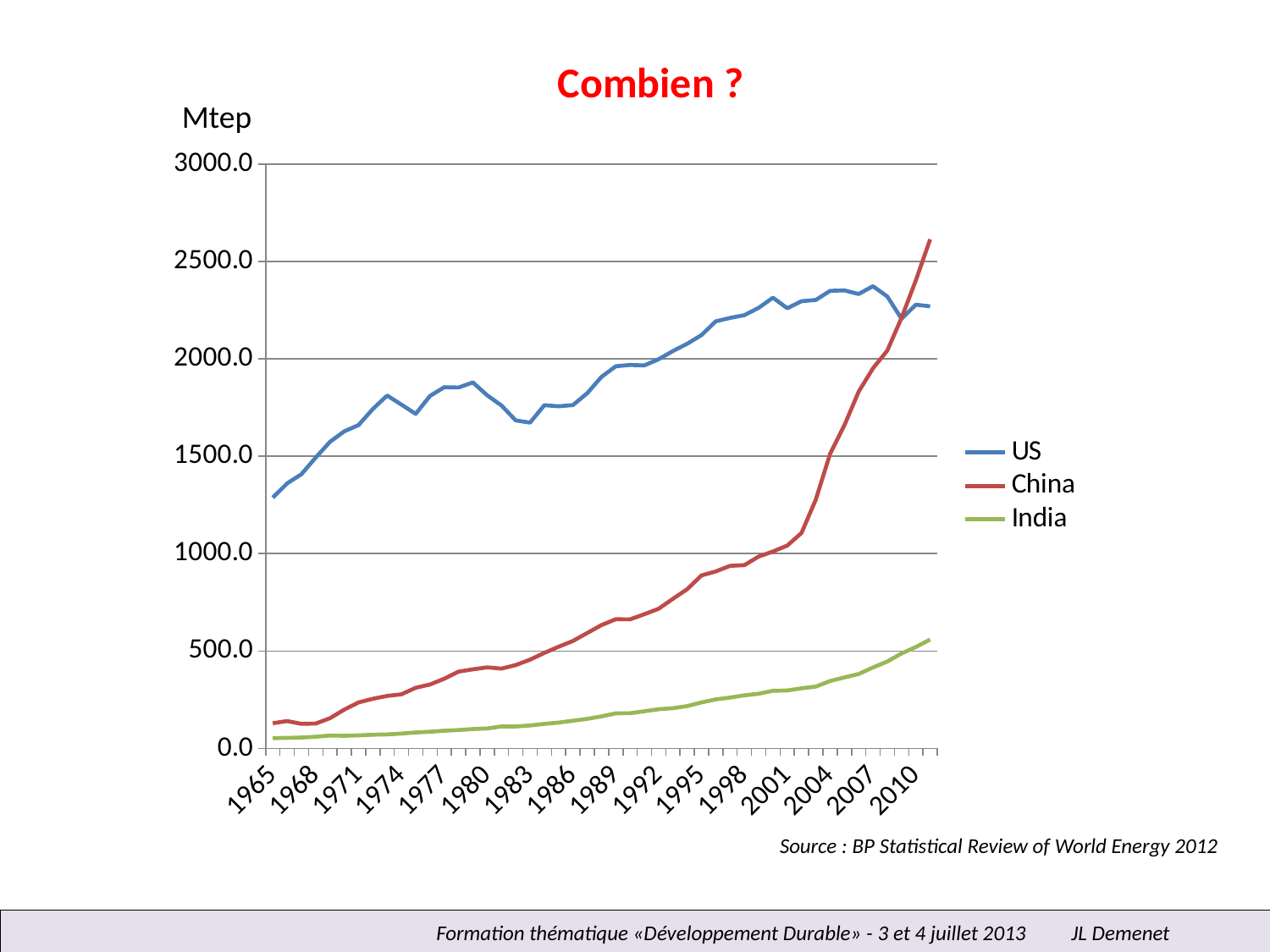
Is the value for US in 2010 greater or less than 2500.0? less How many series does the legend list? 3 Which series has the highest value at the right end of the chart (after 2010)? China Which series has the lowest value in 2010? India Which series are listed in the legend? US, China, India Which series has the highest value in 1965? US What kind of chart is shown on the slide? line chart Is the value for India in 2010 greater or less than 1000.0? less Which is larger in 1980, the value for US or the value for China? US What unit is shown above the vertical axis? Mtep Is the value for China in 1965 greater or less than 500.0? less